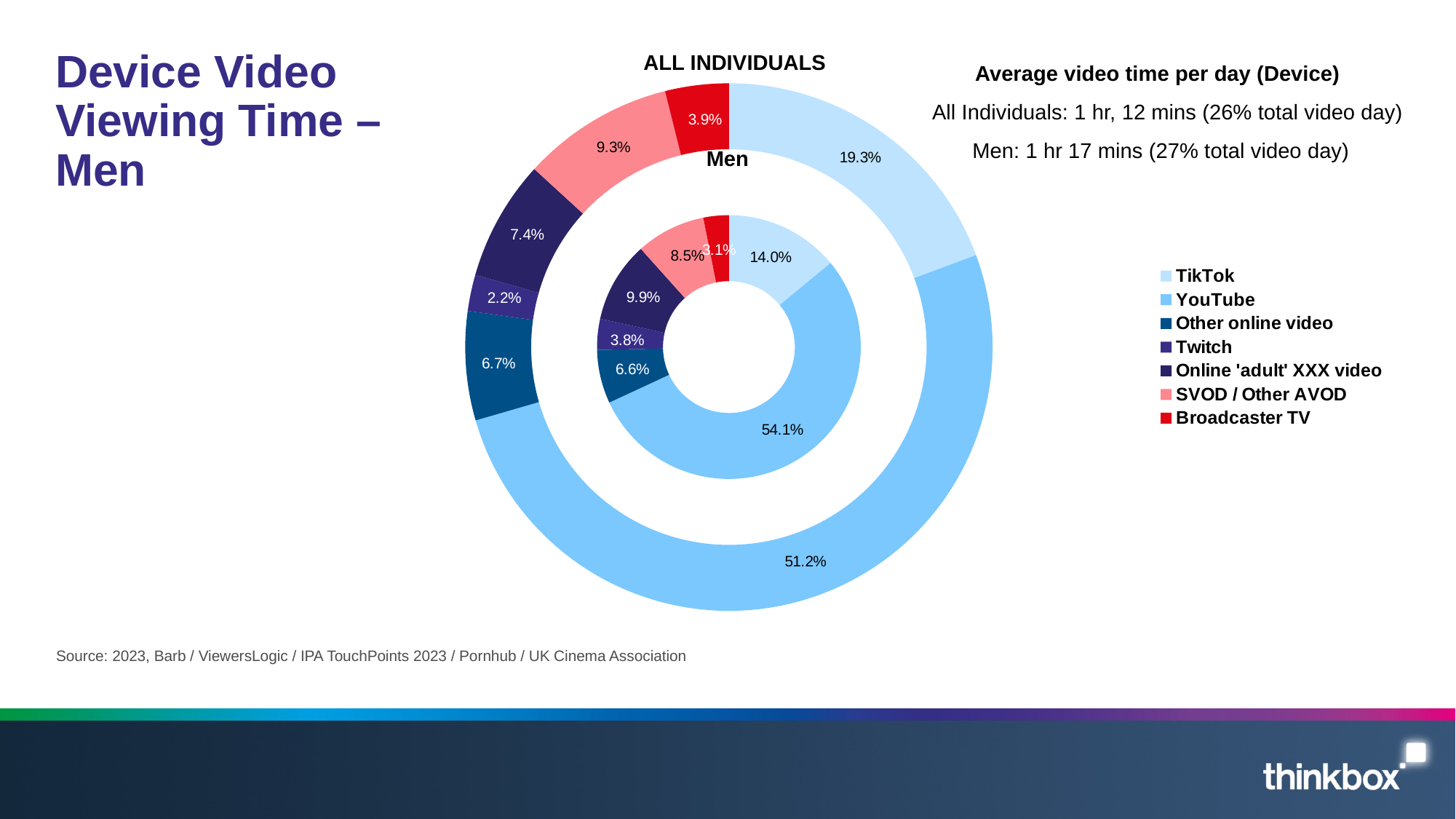
How many series does the legend list? 7 Which is larger: the Online 'adult' XXX video share for Men (inner ring) or for All Individuals (outer ring)? Men In the inner ring (Men), what share does TikTok have? 14.0% What kind of chart is shown on the slide? Doughnut chart In the outer ring (All Individuals), what share does YouTube have? 51.2% In the inner ring (Men), what share does Twitch have? 3.8% Which category has the largest share in the outer ring (All Individuals)? YouTube What is the difference between the TikTok share for All Individuals (outer ring) and for Men (inner ring)? 5.3% In the outer ring (All Individuals), what share does Broadcaster TV have? 3.9% In the inner ring (Men), what share does YouTube have? 54.1% Which category has the smallest share in the inner ring (Men)? Broadcaster TV Which ring of the doughnut chart represents Men? The inner ring